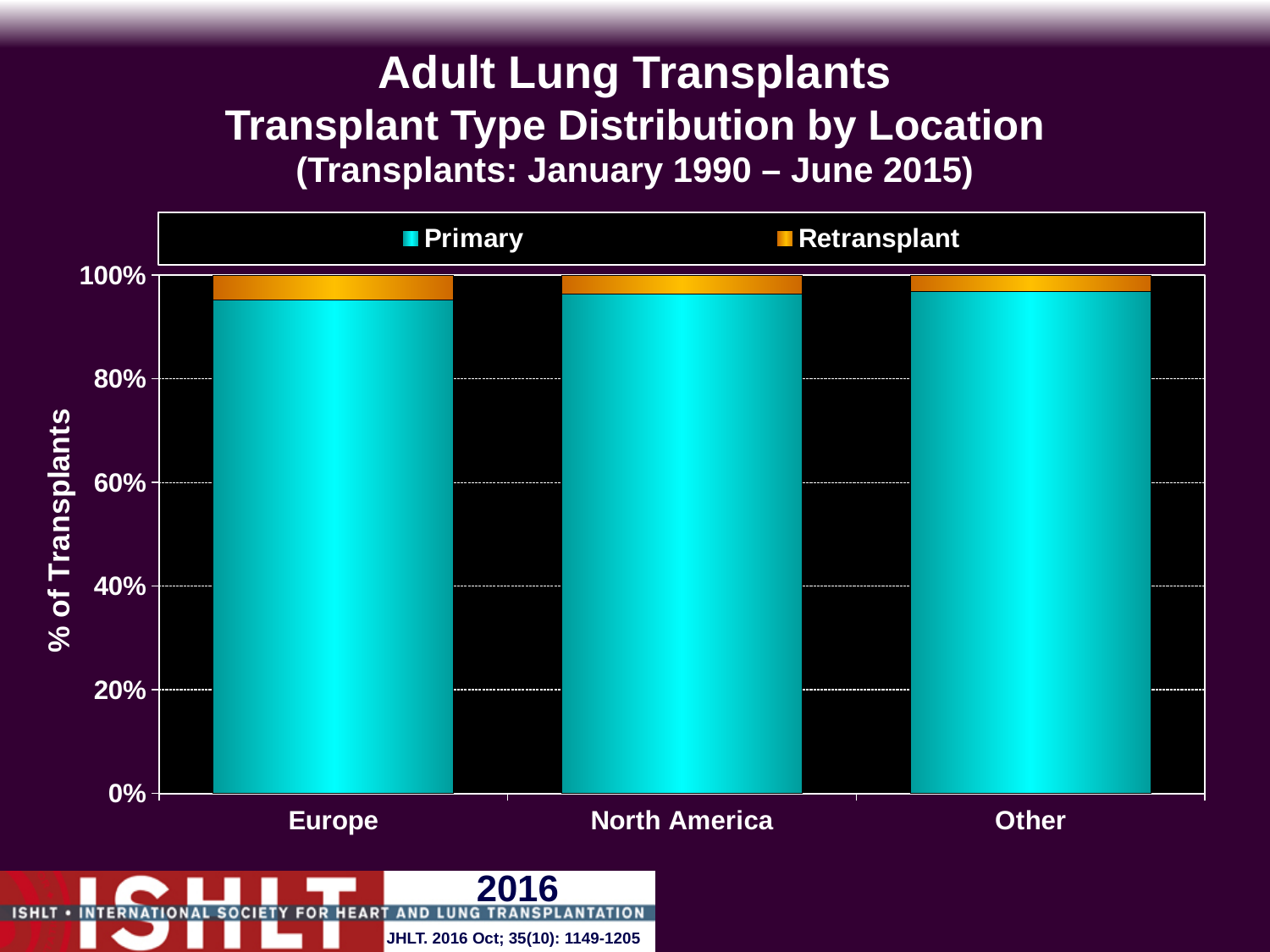
Is the Retransplant value for Other greater or less than 20%? less Is the Retransplant value for Europe greater or less than 20%? less What is the label of the y axis of the chart? % of Transplants How many series does the chart's legend list? 2 What is the total height of the stacked bar for North America? 100% What kind of chart is shown on the slide? stacked bar chart Is the Primary value for Europe greater or less than 80%? greater What are the two series listed in the chart's legend? Primary and Retransplant Which location has the largest Retransplant share? Europe For Europe, which series is larger, Primary or Retransplant? Primary How many locations are shown on the x axis of the chart? 3